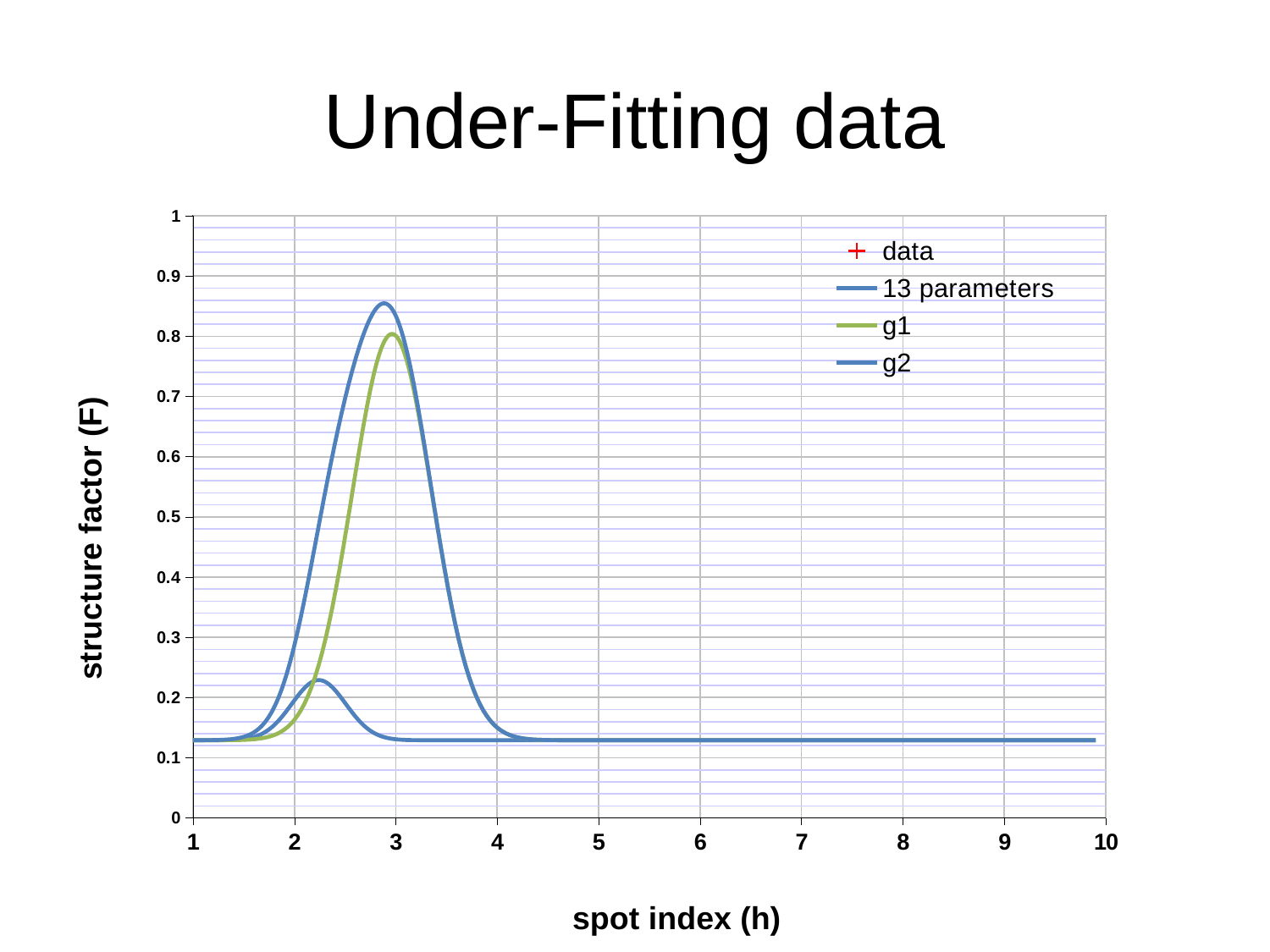
Is the peak value of the g2 curve greater or less than 0.3? less What is the title of the chart on the slide? Under-Fitting data Which of the plotted curves has the lowest peak? g2 Which curve reaches a higher peak, 13 parameters or g2? 13 parameters What is the label of the y axis? structure factor (F) Which curve reaches a higher peak, g1 or g2? g1 What kind of chart is shown on the slide? line chart Is the peak value of the g2 curve greater or less than 0.2? greater Is the value of the 13 parameters curve at spot index 8 greater or less than 0.2? less Between spot index 3 and spot index 4, does the 13 parameters curve rise or fall? fall How many series does the legend list? 4